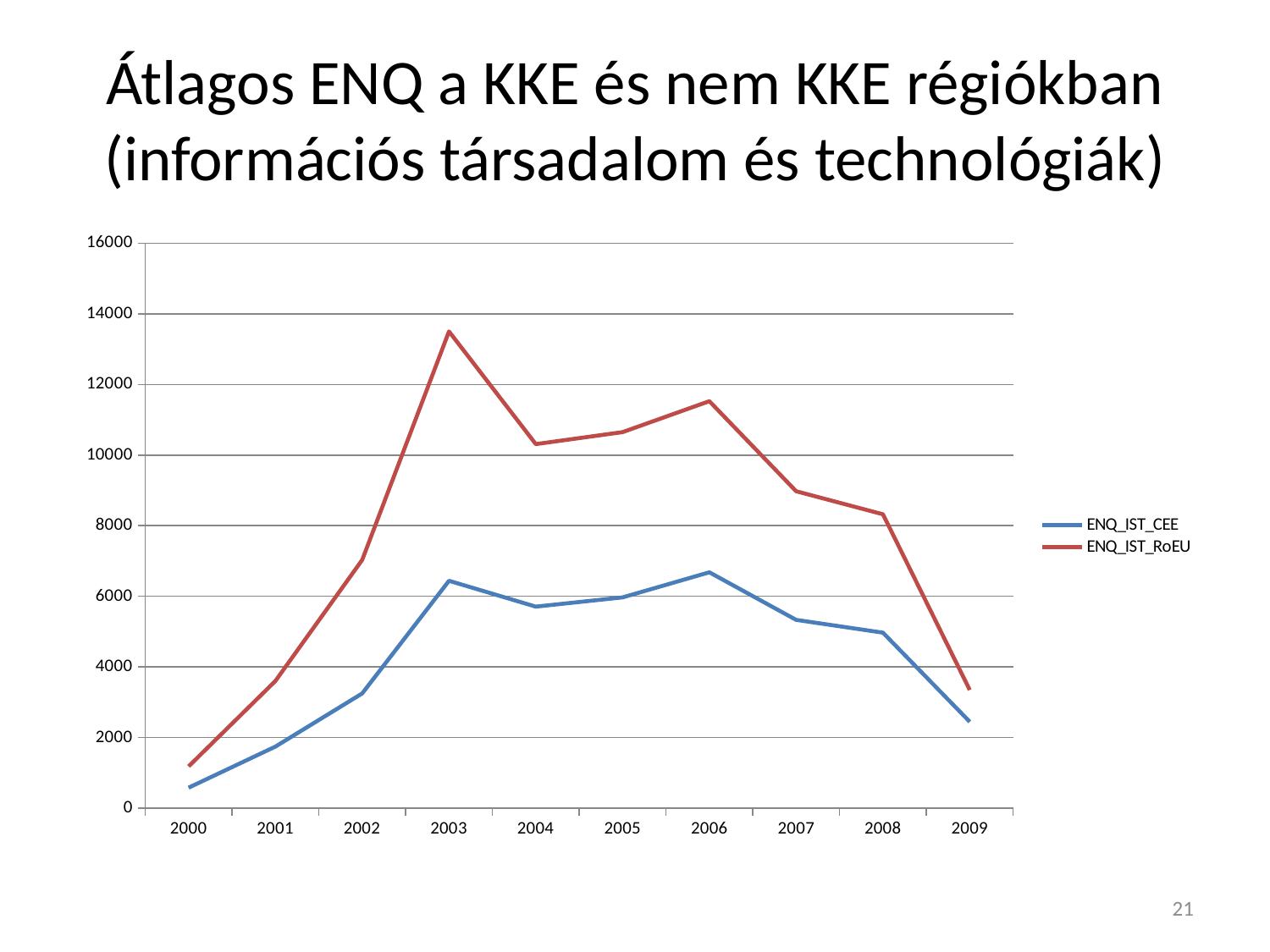
Is the value for ENQ_IST_RoEU in 2003 greater or less than 12000? greater How many series does the legend list? 2 Does ENQ_IST_RoEU rise or fall from 2006 to 2009? fall How many years are plotted along the x axis? 10 Is the value for ENQ_IST_RoEU in 2009 greater or less than 4000? less In which year does ENQ_IST_RoEU reach its highest value? 2003 In which year is ENQ_IST_RoEU at its lowest value? 2000 Is the value for ENQ_IST_CEE in 2000 greater or less than 1000? less Which series has the higher value in 2005, ENQ_IST_CEE or ENQ_IST_RoEU? ENQ_IST_RoEU What kind of chart is shown on the slide? line chart In which year is ENQ_IST_CEE at its lowest value? 2000